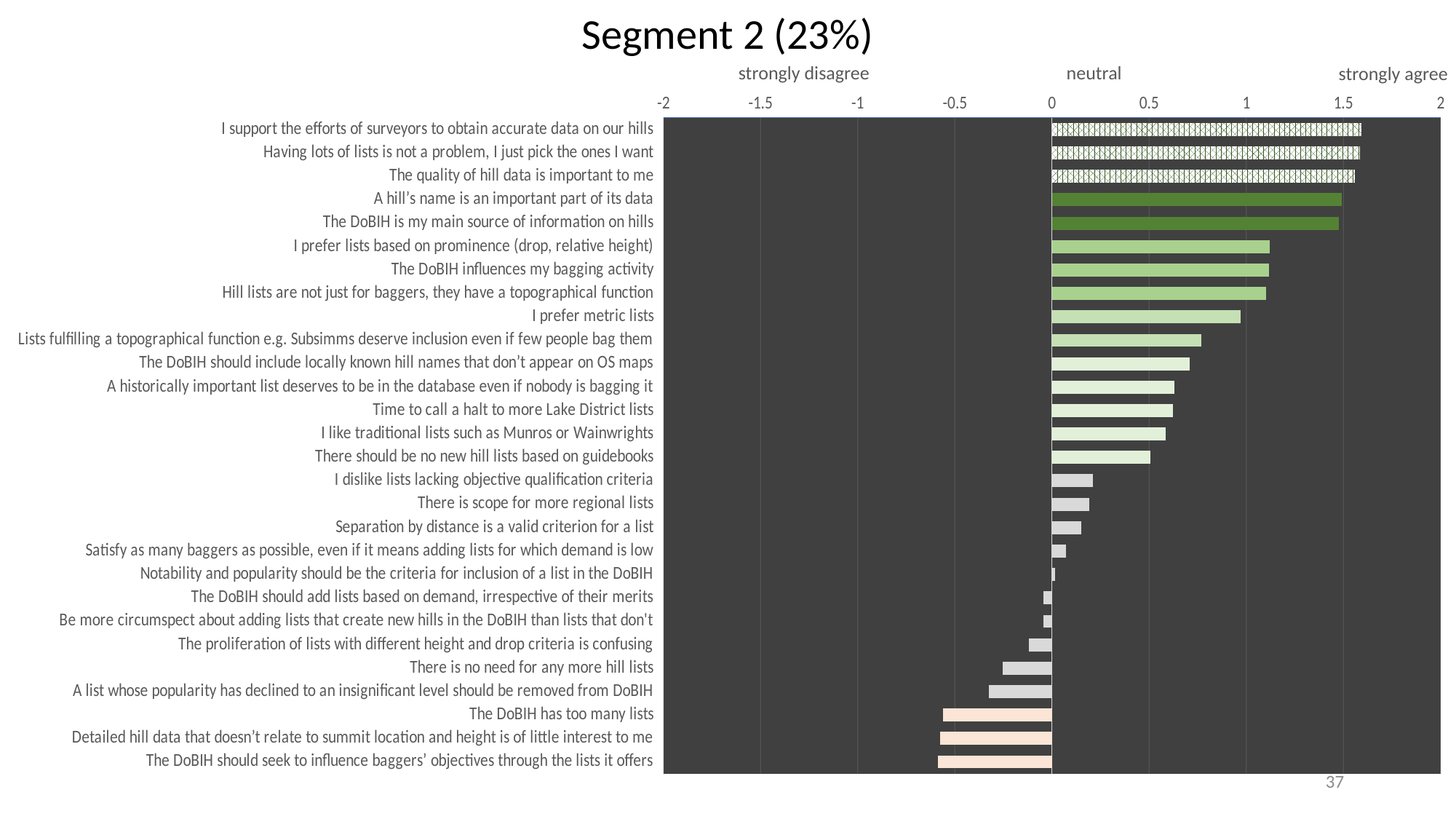
Is the value for "I like traditional lists such as Munros or Wainwrights" greater or less than 0.5? greater Is the value for "Lists fulfilling a topographical function e.g. Subsimms deserve inclusion even if few people bag them" greater or less than 1? less Is the value for "I prefer lists based on prominence (drop, relative height)" greater or less than 1? greater How many statements (categories) are plotted in the chart? 28 Which has the larger value: "There is no need for any more hill lists" or "The DoBIH has too many lists"? There is no need for any more hill lists What is the title of the chart? Segment 2 (23%) What kind of chart is shown on the slide? bar chart What label appears above the 0 point of the horizontal axis? neutral Which has the larger value: "I prefer metric lists" or "I like traditional lists such as Munros or Wainwrights"? I prefer metric lists